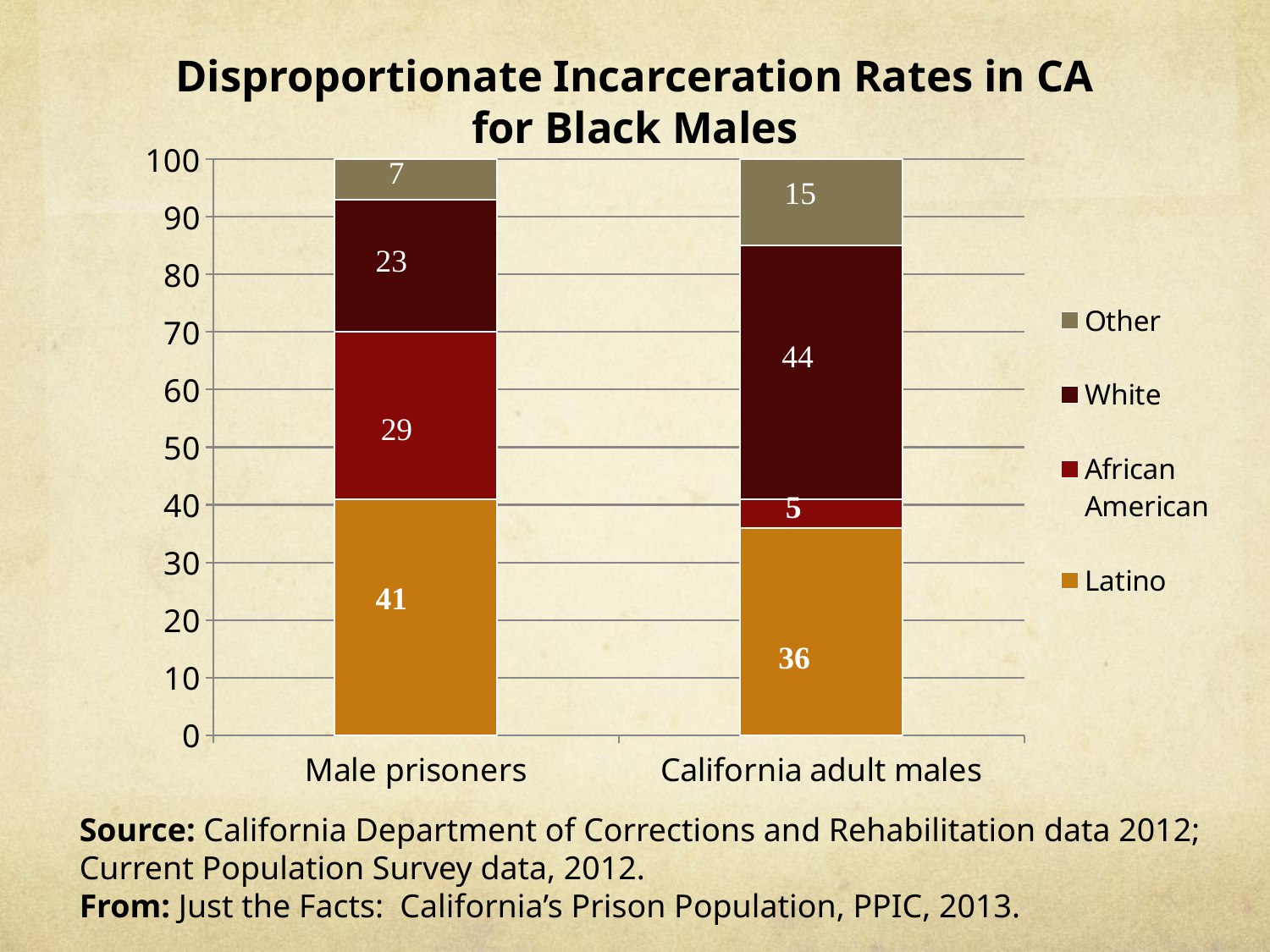
What is the value for White in the California adult males bar? 44 What is the total of the Male prisoners stacked bar? 100 What is the value for Latino in the Male prisoners bar? 41 Which is larger: the White value for Male prisoners or the White value for California adult males? California adult males What is the value for Other in the California adult males bar? 15 What is the value for African American in the Male prisoners bar? 29 How many categories are shown on the x axis? 2 What is the difference between the African American values for Male prisoners and California adult males? 24 Which series has the smallest value in the Male prisoners bar? Other Which series has the largest value in the California adult males bar? White What kind of chart is shown on the slide? Stacked bar chart How many series does the legend list? 4